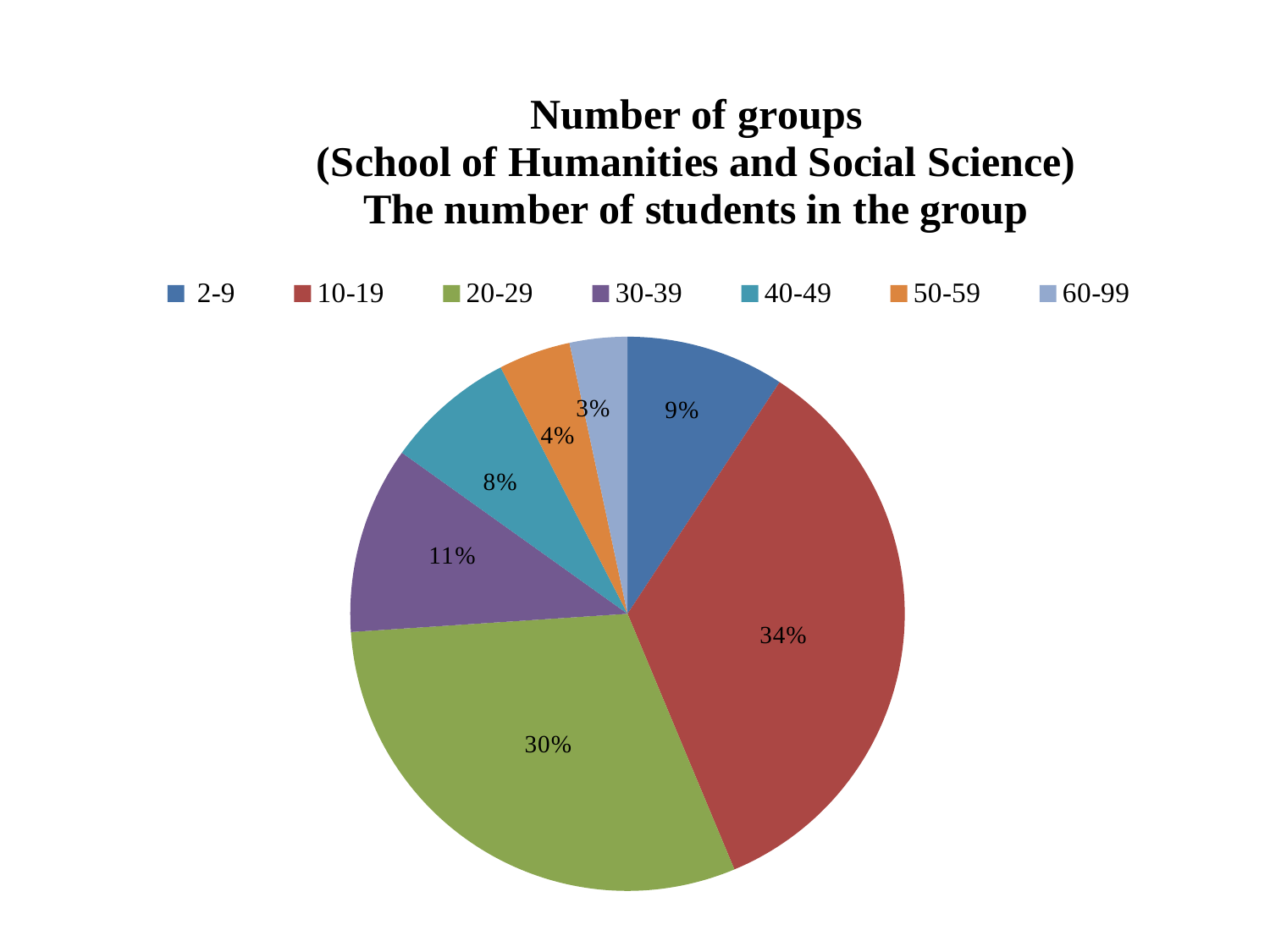
What share of the pie does the 20-29 category have? 30% Which category has the largest slice of the pie? 10-19 What is the difference between the shares of the 50-59 and 60-99 categories? 1% Which is larger, the share for 30-39 or the share for 40-49? 30-39 What is the value shown for the 40-49 category? 8% What is the difference between the shares of the 10-19 and 20-29 categories? 4% What kind of chart is shown on the slide? pie chart What is the value shown for the 2-9 category? 9% How many categories does the pie chart have? 7 Which category has the smallest slice of the pie? 60-99 Which category is shown in green in the pie chart? 20-29 What share of the pie does the 10-19 category have? 34%